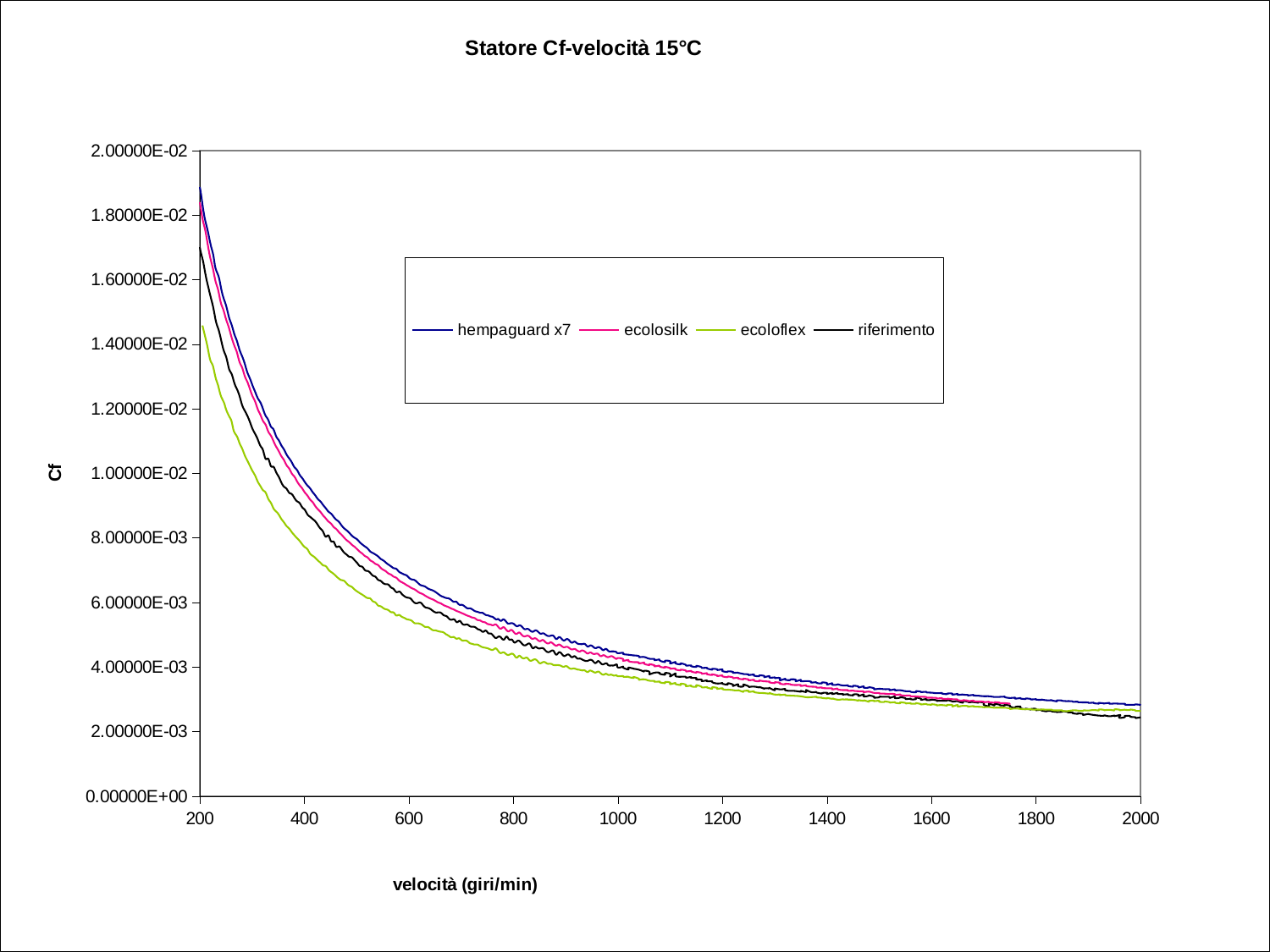
At velocità 600, which series has the larger Cf, hempaguard x7 or ecoloflex? hempaguard x7 Which series has the lowest Cf at velocità 200? ecoloflex Is the Cf value for hempaguard x7 at velocità 2000 greater or less than 2.00000E-03? greater Is the Cf value for hempaguard x7 at velocità 200 greater or less than 1.80000E-02? greater Which series has the highest Cf at velocità 200? hempaguard x7 Is the Cf value for ecoloflex at velocità 200 greater or less than 1.60000E-02? less What is the label of the x axis? velocità (giri/min) Do the Cf values rise or fall as velocità increases? fall What is the title of the chart? Statore Cf-velocità 15°C What kind of chart is shown on the slide? line chart How many series does the legend list? 4